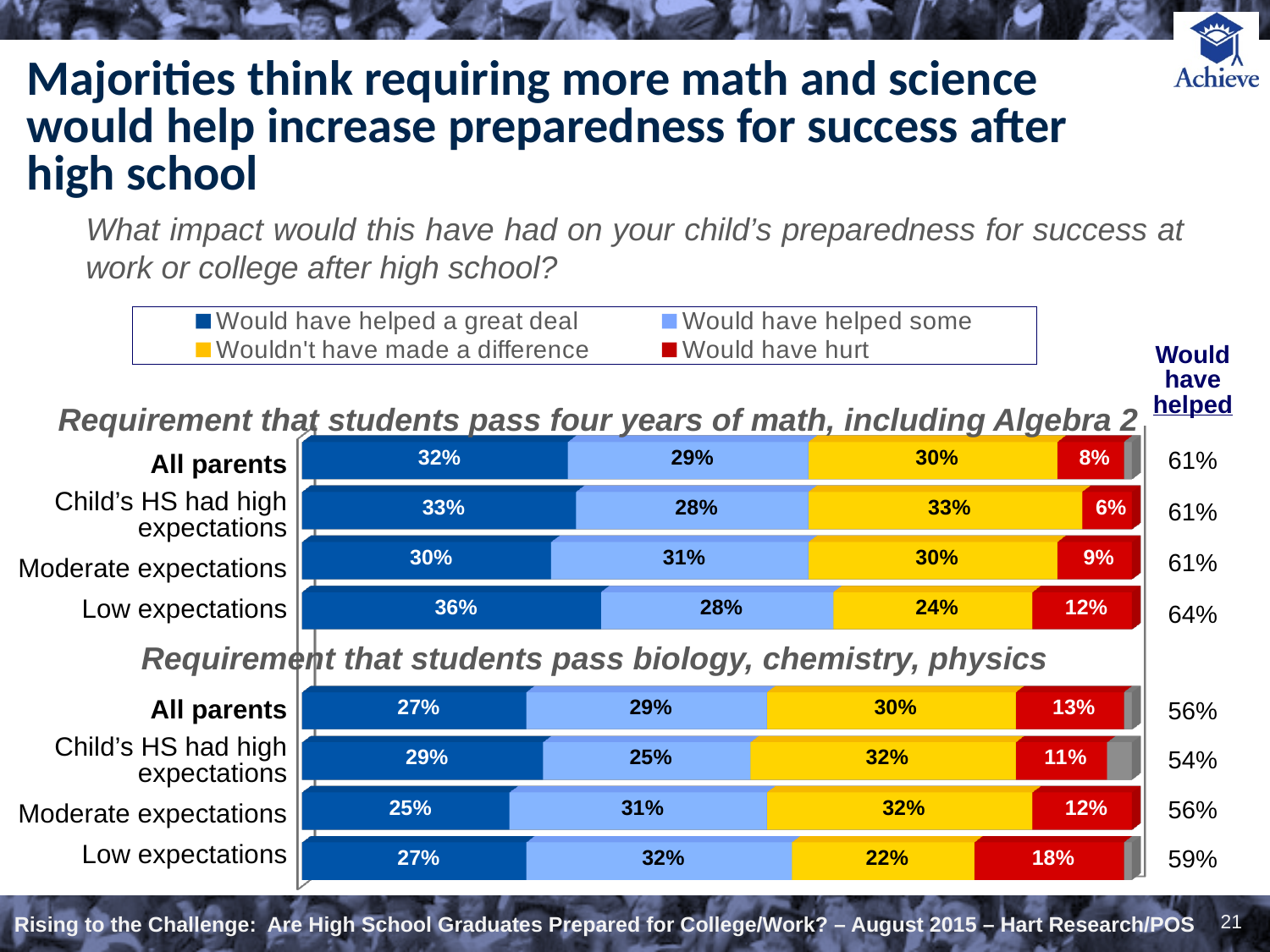
What kind of chart is shown on the slide? stacked bar chart In the 'Requirement that students pass four years of math, including Algebra 2' section, what percentage of all parents said it would have helped a great deal? 32% How many bars are plotted on the chart in total across both sections? 8 In the 'Requirement that students pass four years of math, including Algebra 2' section, which group has the highest 'Would have helped a great deal' value? Low expectations In the 'Requirement that students pass four years of math, including Algebra 2' section, what is the difference between the 'Would have hurt' values for Low expectations and Child's HS had high expectations? 6% In the 'Requirement that students pass biology, chemistry, physics' section, which group has the lowest 'Would have helped a great deal' value? Moderate expectations In the 'Requirement that students pass biology, chemistry, physics' section, which is larger for all parents: 'Would have helped some' or 'Wouldn't have made a difference'? Wouldn't have made a difference In the 'Requirement that students pass biology, chemistry, physics' section, what percentage of parents whose child's HS had low expectations said it would have hurt? 18% In the 'Requirement that students pass biology, chemistry, physics' section, what is the combined 'Would have helped a great deal' and 'Would have helped some' value for Child's HS had high expectations? 54% What is the 'Would have helped' total shown for Low expectations in the 'Requirement that students pass four years of math, including Algebra 2' section? 64% How many series does the legend list? 4 Which colour represents 'Would have hurt' in the legend? red